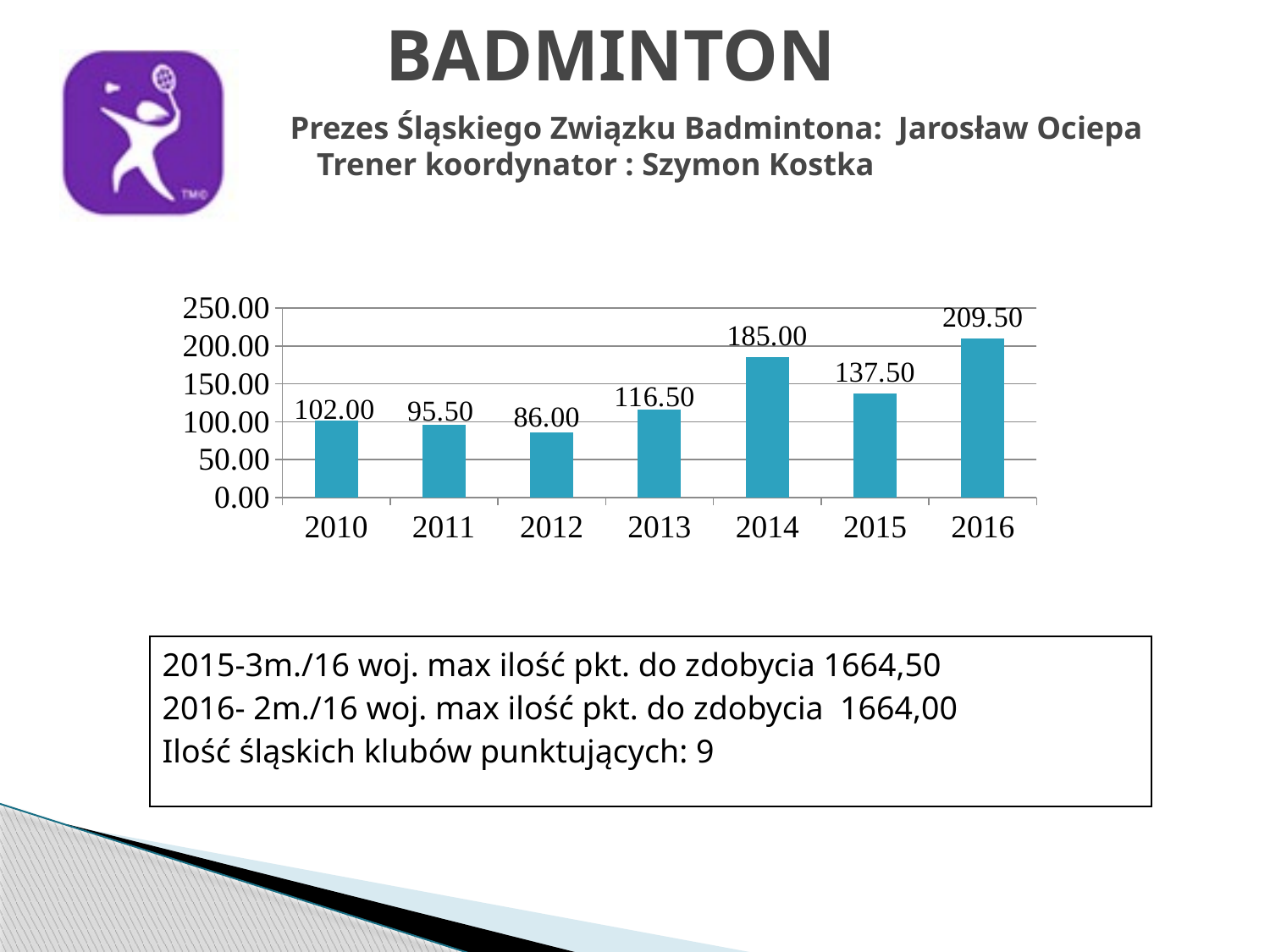
What is the value for 2014? 185.00 Does the value rise or fall from 2010 to 2012? fall How many years are shown on the x axis? 7 What kind of chart is shown on the slide? bar chart What is the value for 2010? 102.00 What is the value for 2016? 209.50 What is the difference between the values for 2016 and 2015? 72.00 Which year has the highest value? 2016 Which year has the lowest value? 2012 Which is larger, the value for 2011 or the value for 2013? 2013 Is the value for 2015 greater or less than 100.00? greater What is the difference between the values for 2014 and 2013? 68.50